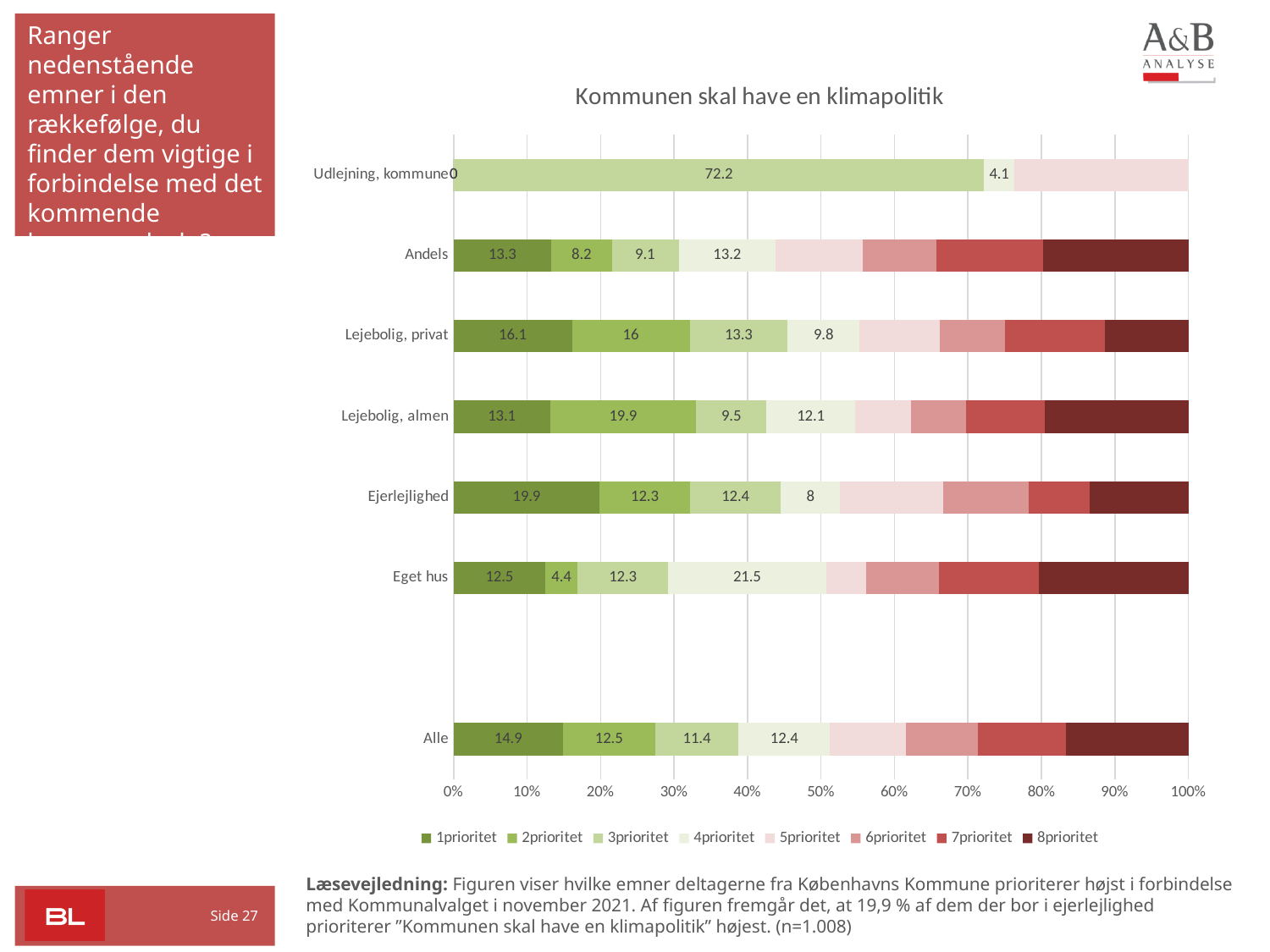
Which category has the highest 1prioritet value? Ejerlejlighed What is the 1prioritet value for Ejerlejlighed? 19.9 Is the 1prioritet value for Alle greater or less than 10%? greater Which has the larger 2prioritet value, Lejebolig, almen or Ejerlejlighed? Lejebolig, almen Which category has the lowest 1prioritet value? Udlejning, kommune How many series does the legend list? 8 How many categories (housing types) are plotted on the y axis of the chart? 7 What is the difference between the 1prioritet values for Lejebolig, privat and Andels? 2.8 What kind of chart is shown on the slide? Stacked bar chart What is the 4prioritet value for Eget hus? 21.5 What is the title of the chart? Kommunen skal have en klimapolitik What is the 3prioritet value for Alle? 11.4